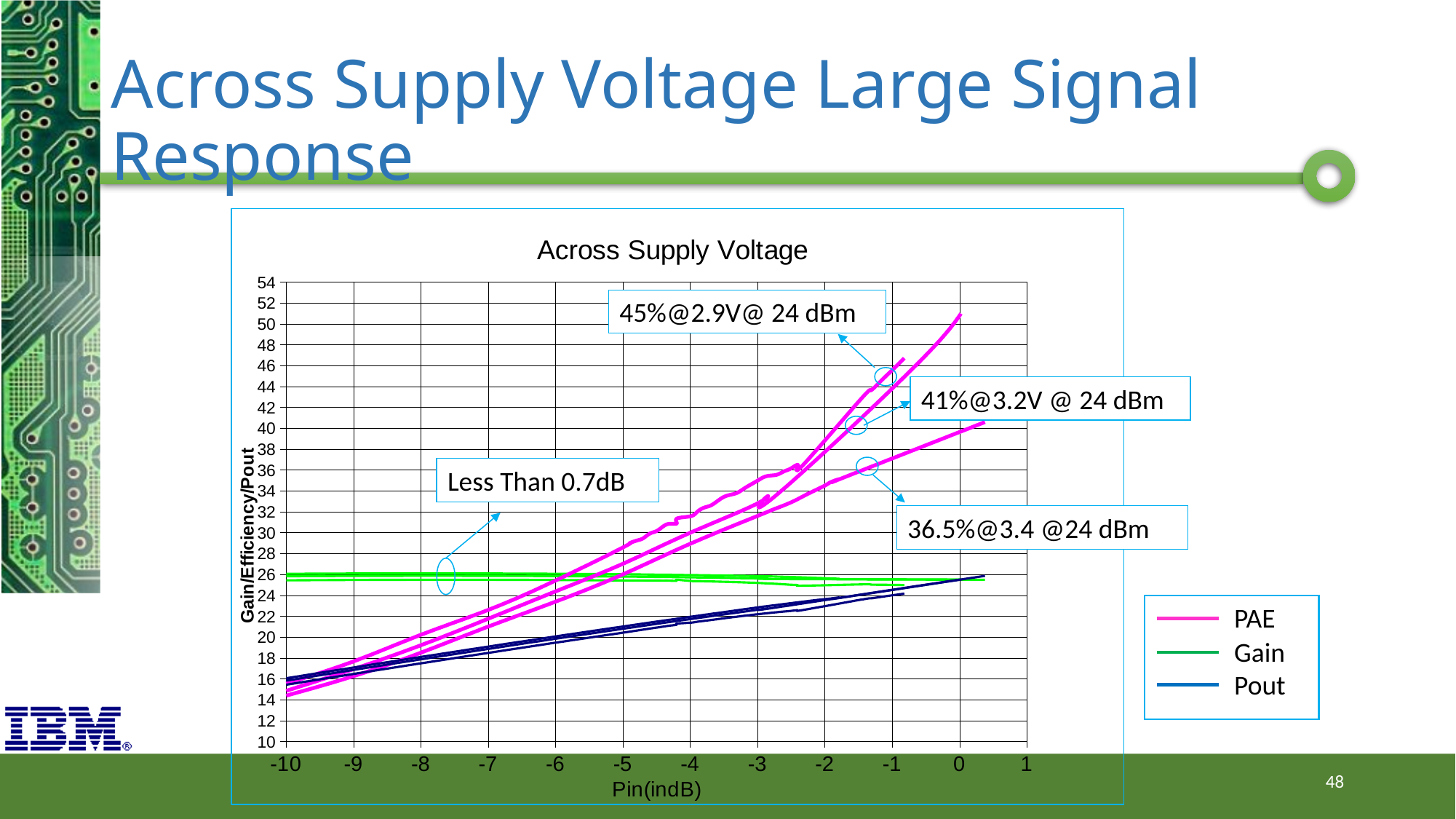
According to the annotation, what PAE is achieved at 2.9V at 24 dBm? 45% What are the series names listed in the legend? PAE, Gain, Pout Is the highest PAE curve at Pin = 0 greater or less than 46? greater What kind of chart is shown on the slide? line chart At Pin = -10, which series has the higher value, Gain or Pout? Gain Is the Pout value at Pin = 0 greater or less than 20? greater What is the title of the chart? Across Supply Voltage Is the Gain value at Pin = -10 greater or less than 20? greater How many series does the legend list? 3 Do the PAE curves rise or fall as Pin increases from -10 to 0? rise At Pin = 0, which series has the higher value, PAE or Gain? PAE